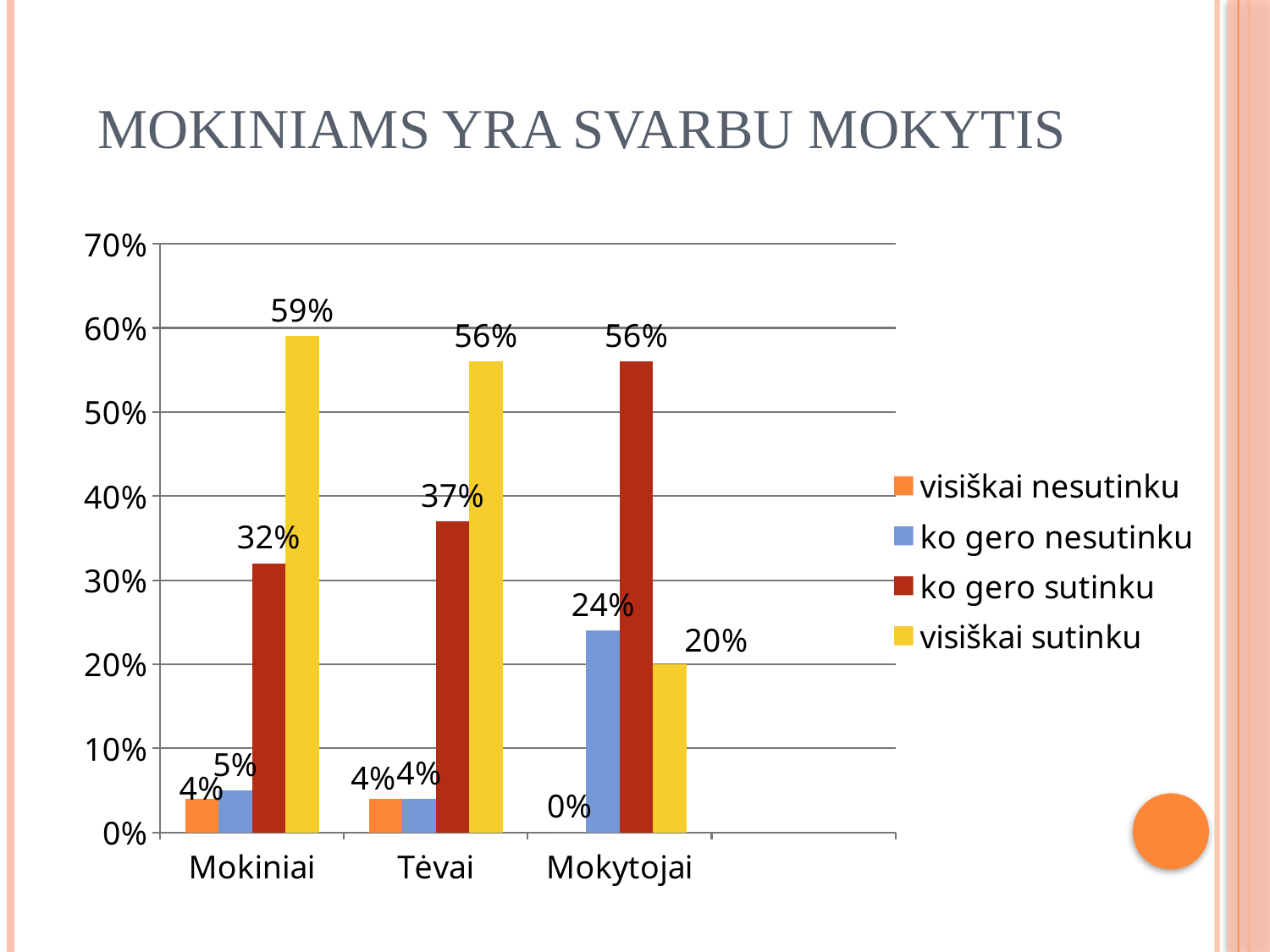
What is the value for "visiškai sutinku" in the Mokiniai category? 59% How many categories are shown on the x axis? 3 What is the value for "visiškai nesutinku" in the Mokytojai category? 0% What is the title of the slide? MOKINIAMS YRA SVARBU MOKYTIS What is the value for "ko gero nesutinku" in the Mokytojai category? 24% Which category has the lowest value for "visiškai sutinku"? Mokytojai What is the value for "ko gero sutinku" in the Tėvai category? 37% What kind of chart is shown on the slide? bar chart Which is larger: "ko gero sutinku" for Mokytojai or "visiškai sutinku" for Mokytojai? ko gero sutinku Which category has the highest value for "visiškai sutinku"? Mokiniai What is the difference between the "ko gero sutinku" values for Mokytojai and Mokiniai? 24% How many series does the legend list? 4